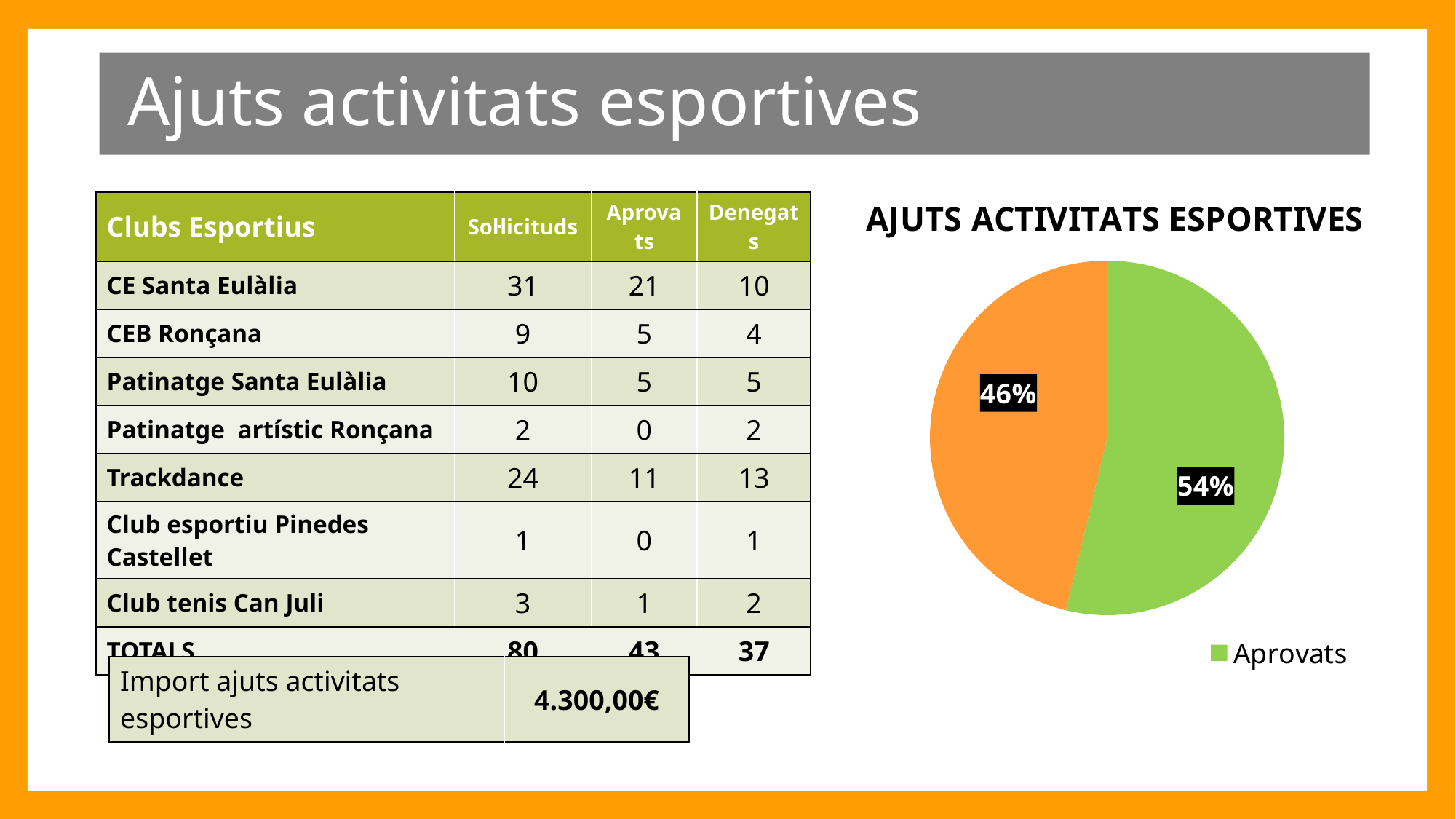
What is the title of the pie chart? AJUTS ACTIVITATS ESPORTIVES Which is larger in the pie chart, the green Aprovats slice or the orange slice? the green Aprovats slice How many slices does the pie chart have? 2 What colour is the Aprovats slice in the pie chart? green Which entry is listed in the legend of the pie chart? Aprovats What kind of chart is shown on the slide? pie chart What percentage does the Aprovats slice of the pie chart show? 54% Which slice of the pie chart is the largest? Aprovats (54%) What percentage is shown on the smallest slice of the pie chart? 46% Is the Aprovats share in the pie chart greater or less than 50%? greater What percentage is shown on the orange slice of the pie chart? 46% What is the difference in percentage points between the 54% slice and the 46% slice of the pie chart? 8 percentage points